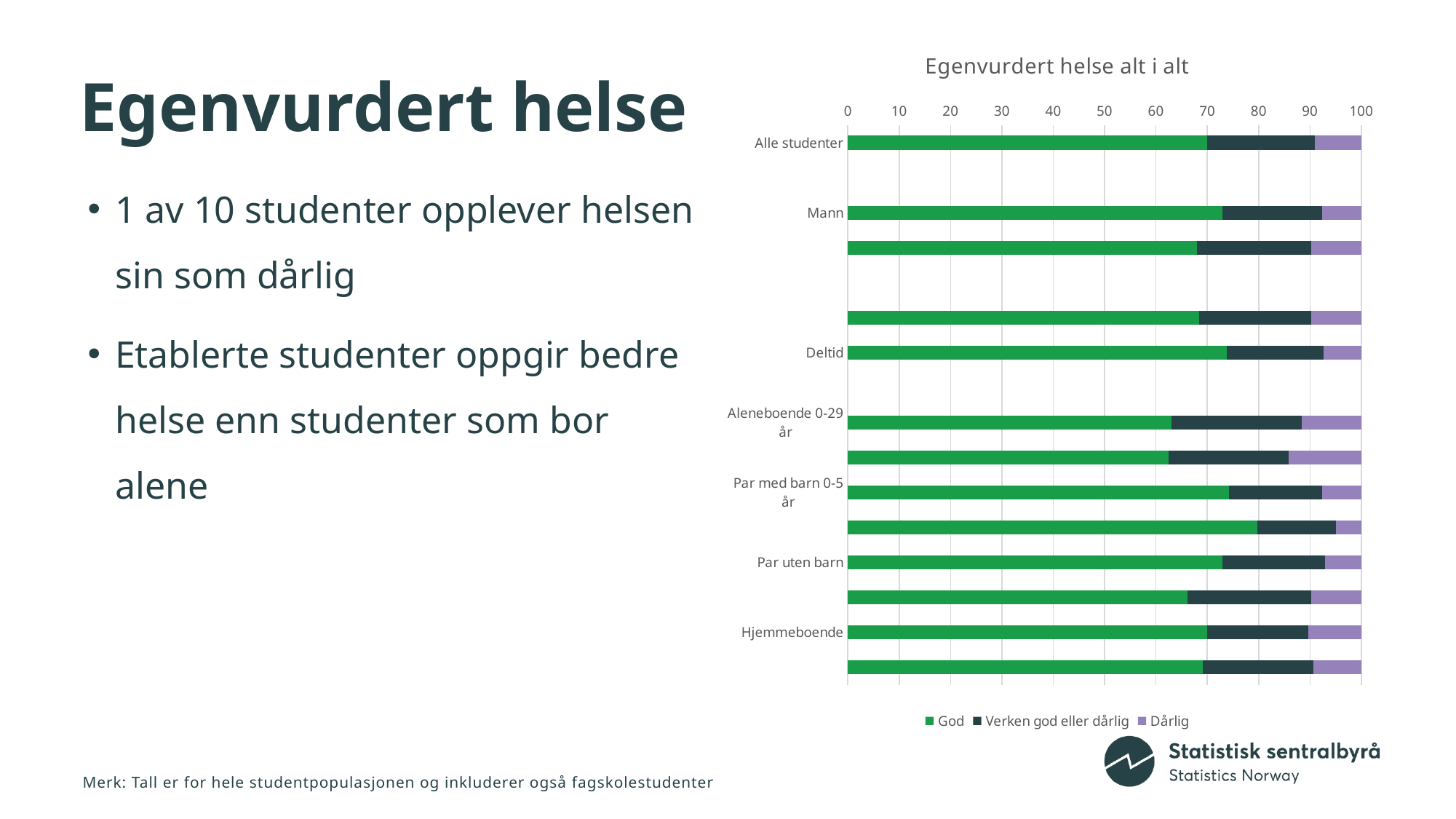
How many series does the chart legend list? 3 What kind of chart is shown on the slide? Stacked bar chart Which has the larger 'God' value, Aleneboende 0-29 år or Par med barn 0-5 år? Par med barn 0-5 år Is the 'God' value for Alle studenter greater or less than 60? greater Is the 'God' value for Mann greater or less than 60? greater What is the maximum value shown on the x axis of the chart? 100 Which series is shown in purple in the chart? Dårlig What is the title of the chart? Egenvurdert helse alt i alt Among the labelled categories, which has the lowest 'God' value? Aleneboende 0-29 år Is the 'God' value for Hjemmeboende greater or less than 60? greater